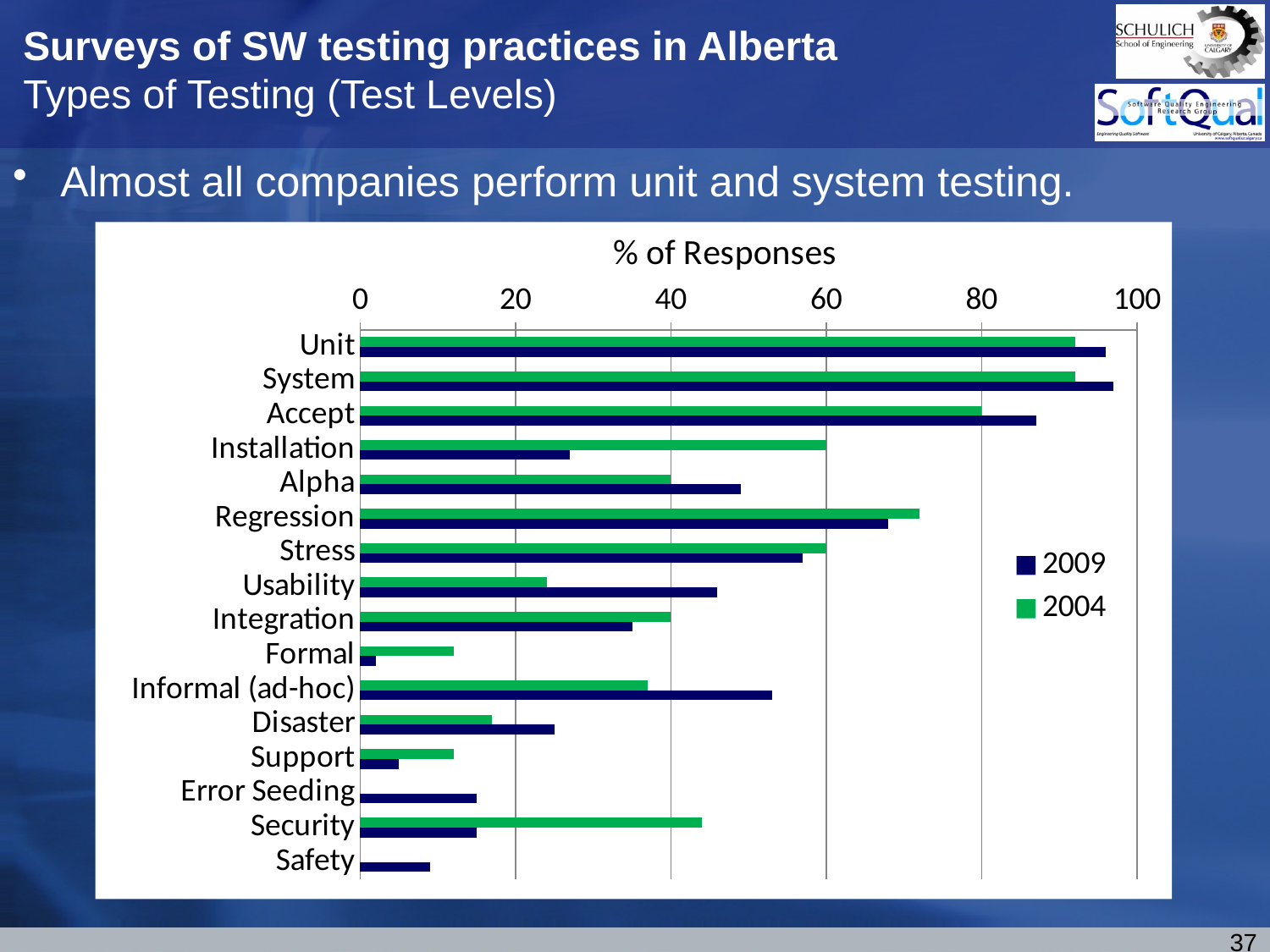
What is the title shown above the chart's value axis? % of Responses Is the 2004 value for Regression greater or less than 60? greater Is the 2009 value for Formal greater or less than 20? less How many series does the legend list? 2 What kind of chart is shown on the slide? Bar chart Is the 2004 value for Installation greater or less than 40? greater For Installation, which year has the larger value, 2009 or 2004? 2004 Which series is drawn in green in the chart? 2004 How many types of testing are listed on the chart's category axis? 16 For Usability, which year has the larger value, 2009 or 2004? 2009 Which type of testing has the lowest 2009 value? Formal